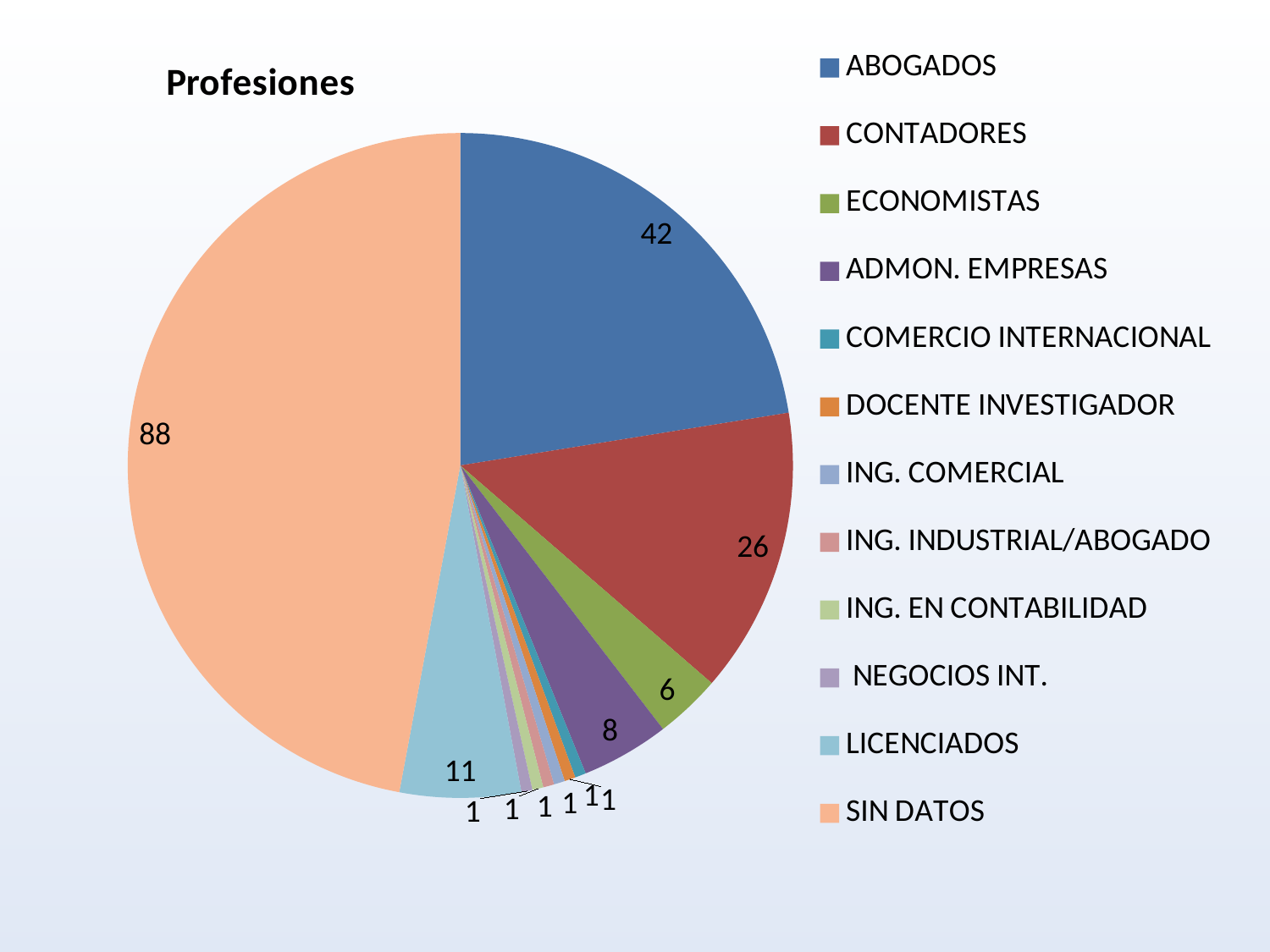
What is the value for CONTADORES? 26 What is the value for ADMON. EMPRESAS? 8 What is the value for SIN DATOS? 88 Which category has the largest slice of the pie? SIN DATOS What is the value for ABOGADOS? 42 What is the title of the chart? Profesiones How many categories does the legend of the pie chart list? 12 What type of chart is shown on the slide? pie chart What is the difference between the values for SIN DATOS and ABOGADOS? 46 What is the difference between the values for ADMON. EMPRESAS and ECONOMISTAS? 2 What is the value for LICENCIADOS? 11 Which is larger, the value for CONTADORES or the value for LICENCIADOS? CONTADORES